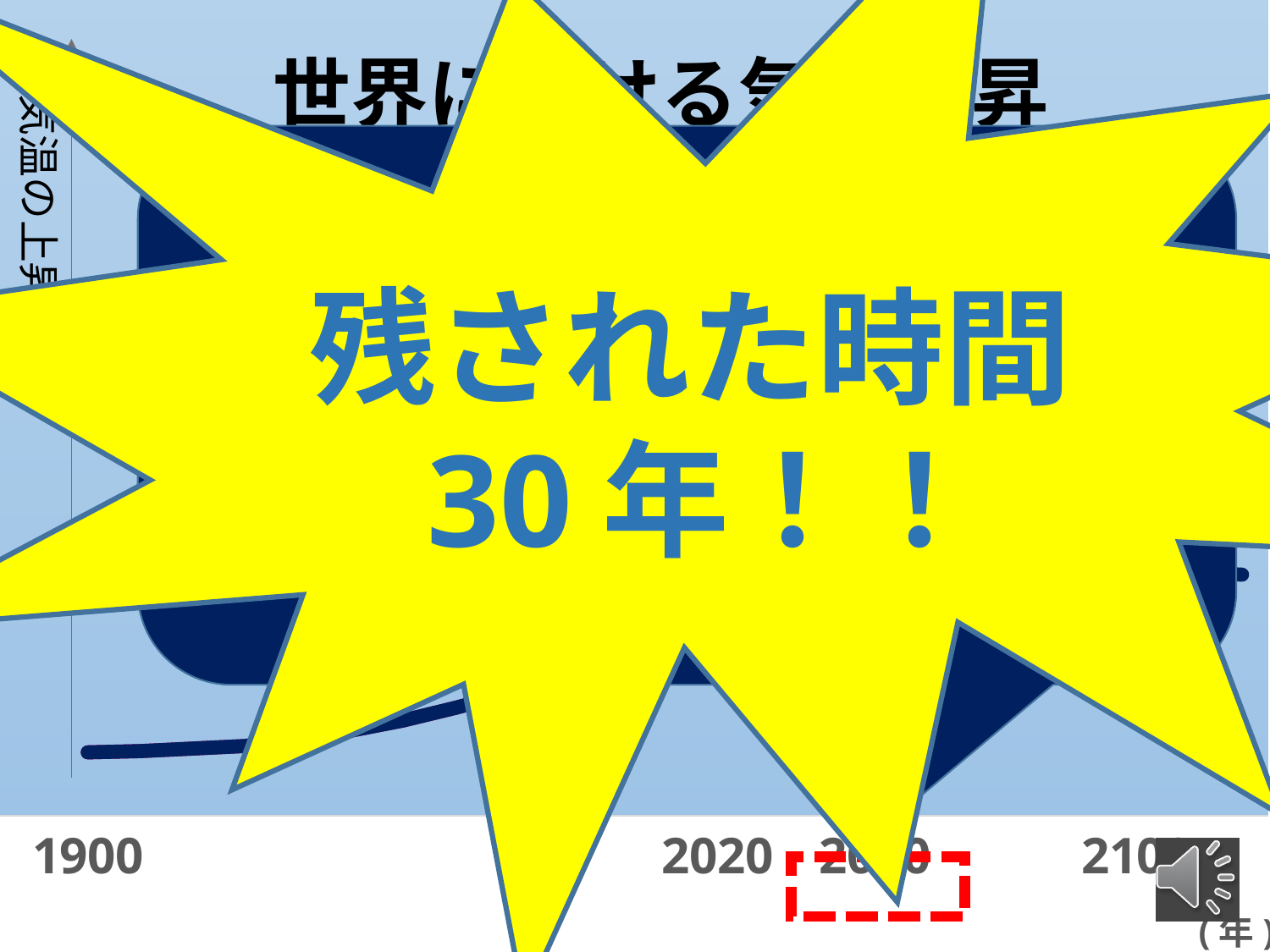
What is the leftmost label on the x axis of the chart? 1900 Does the plotted line rise or fall as the years increase from 1900? rise What unit is shown at the right end of the chart's x axis? 年 What kind of chart is shown on the slide? line chart